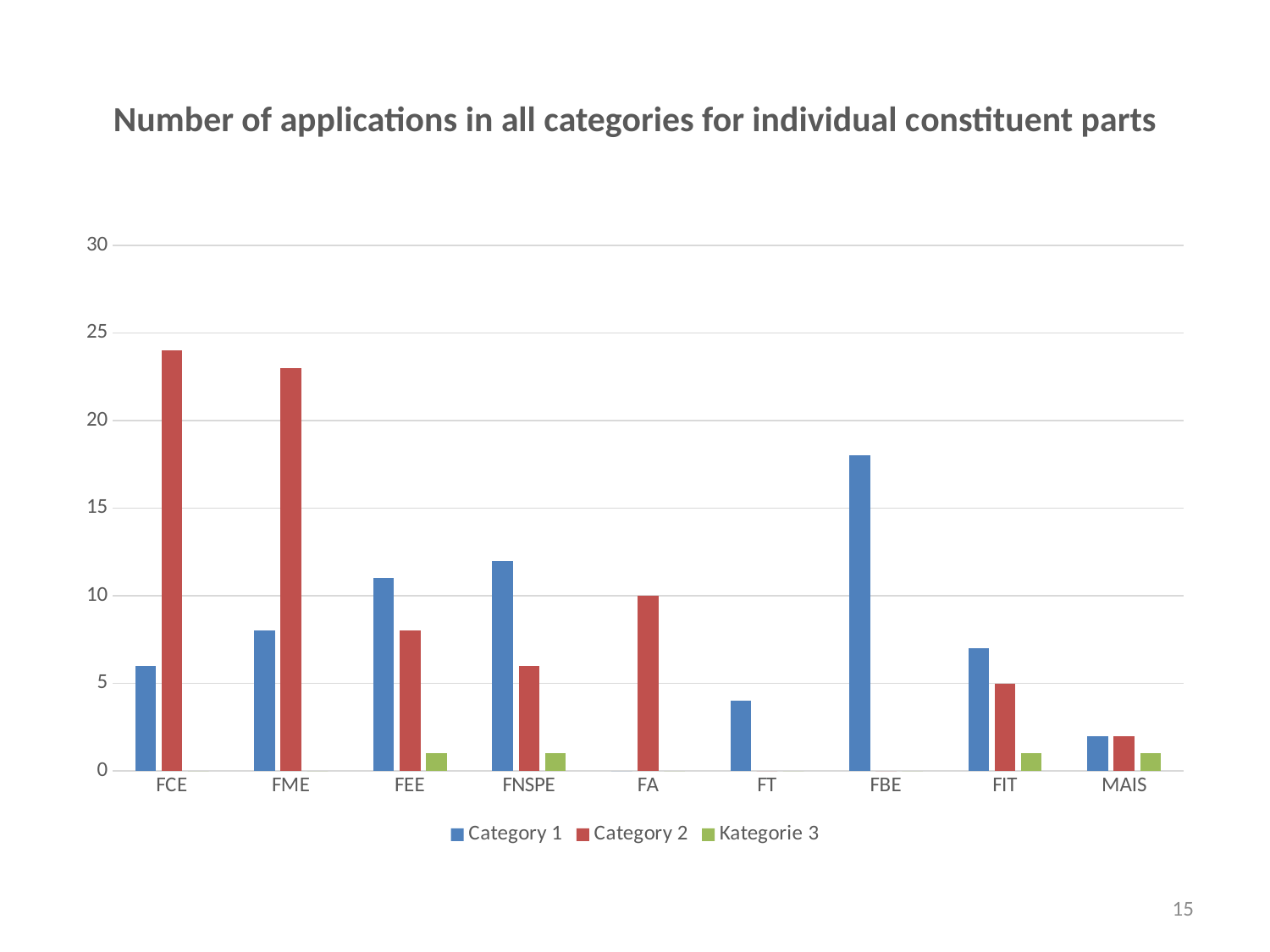
Is the Category 1 value for FBE greater or less than 15? greater Is the Category 1 value for FT greater or less than 5? less What kind of chart is shown on the slide? bar chart Which constituent part has the highest Category 1 value? FBE What is the name of the third series in the legend? Kategorie 3 Is the Category 1 value for FEE greater or less than 10? greater Which is larger, the Category 2 value for FA or the Category 2 value for MAIS? FA What is the title of the chart? Number of applications in all categories for individual constituent parts Which is larger, the Category 1 value for FBE or the Category 1 value for FIT? FBE How many series does the legend list? 3 How many constituent parts (categories) are shown on the x axis? 9